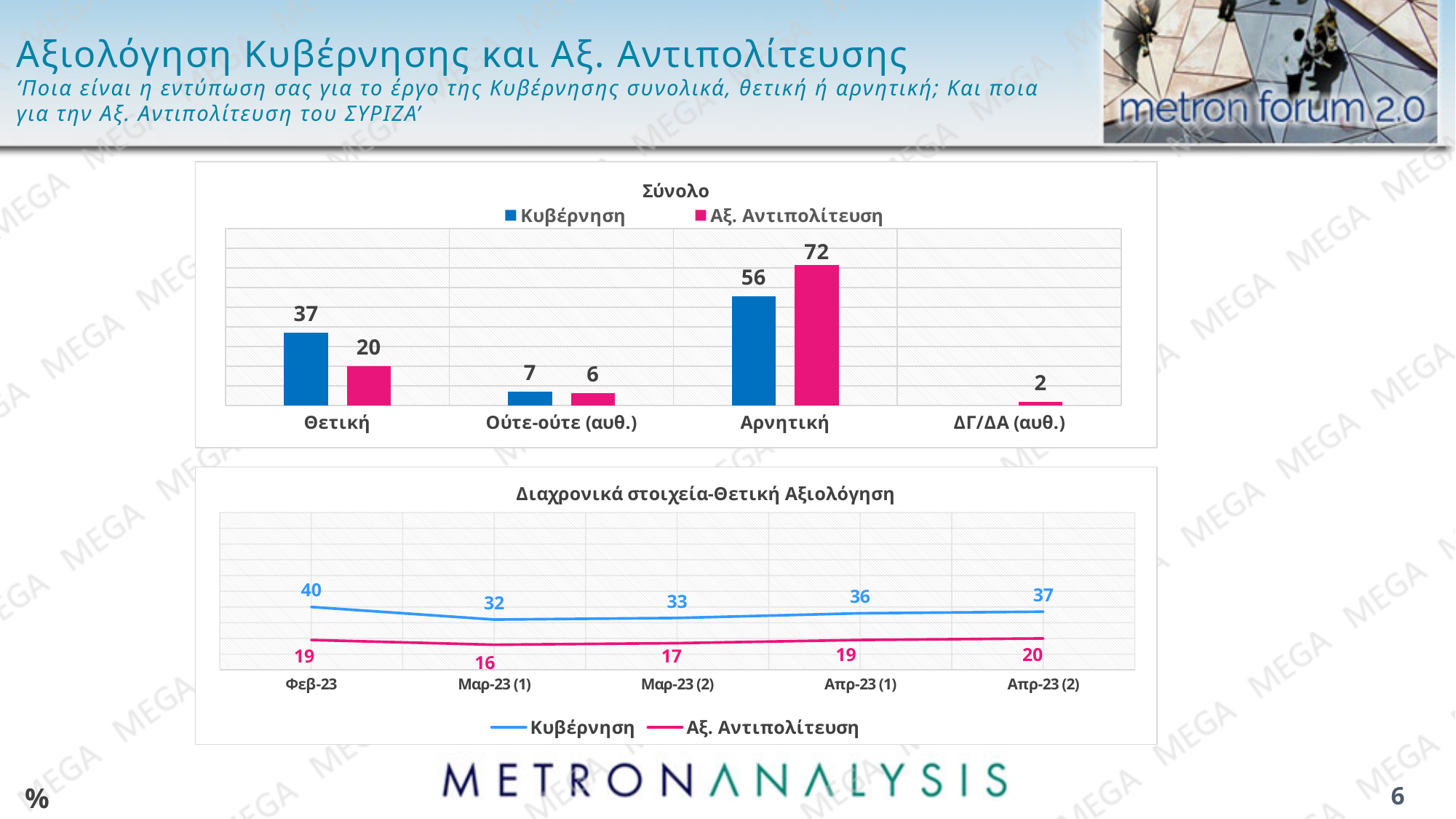
In the 'Σύνολο' chart, what is the value for Κυβέρνηση in the Θετική category? 37 In the 'Διαχρονικά στοιχεία-Θετική Αξιολόγηση' chart, what is the difference between Κυβέρνηση and Αξ. Αντιπολίτευση at Απρ-23 (2)? 17 What kind of chart is the 'Σύνολο' chart? Bar chart In the 'Διαχρονικά στοιχεία-Θετική Αξιολόγηση' chart, what is the value for Κυβέρνηση at Φεβ-23? 40 In the 'Σύνολο' chart, what is the difference between Αξ. Αντιπολίτευση and Κυβέρνηση in the Αρνητική category? 16 What kind of chart is the 'Διαχρονικά στοιχεία-Θετική Αξιολόγηση' chart? Line chart In the 'Σύνολο' chart, which category has the highest value for Κυβέρνηση? Αρνητική In the 'Σύνολο' chart, what is the value for Αξ. Αντιπολίτευση in the Αρνητική category? 72 In the 'Διαχρονικά στοιχεία-Θετική Αξιολόγηση' chart, what is the value for Αξ. Αντιπολίτευση at Μαρ-23 (1)? 16 In the 'Σύνολο' chart, which is larger in the Θετική category: Κυβέρνηση or Αξ. Αντιπολίτευση? Κυβέρνηση In the 'Σύνολο' chart, how many series does the legend list? 2 In the 'Διαχρονικά στοιχεία-Θετική Αξιολόγηση' chart, how many time points are shown on the x axis? 5